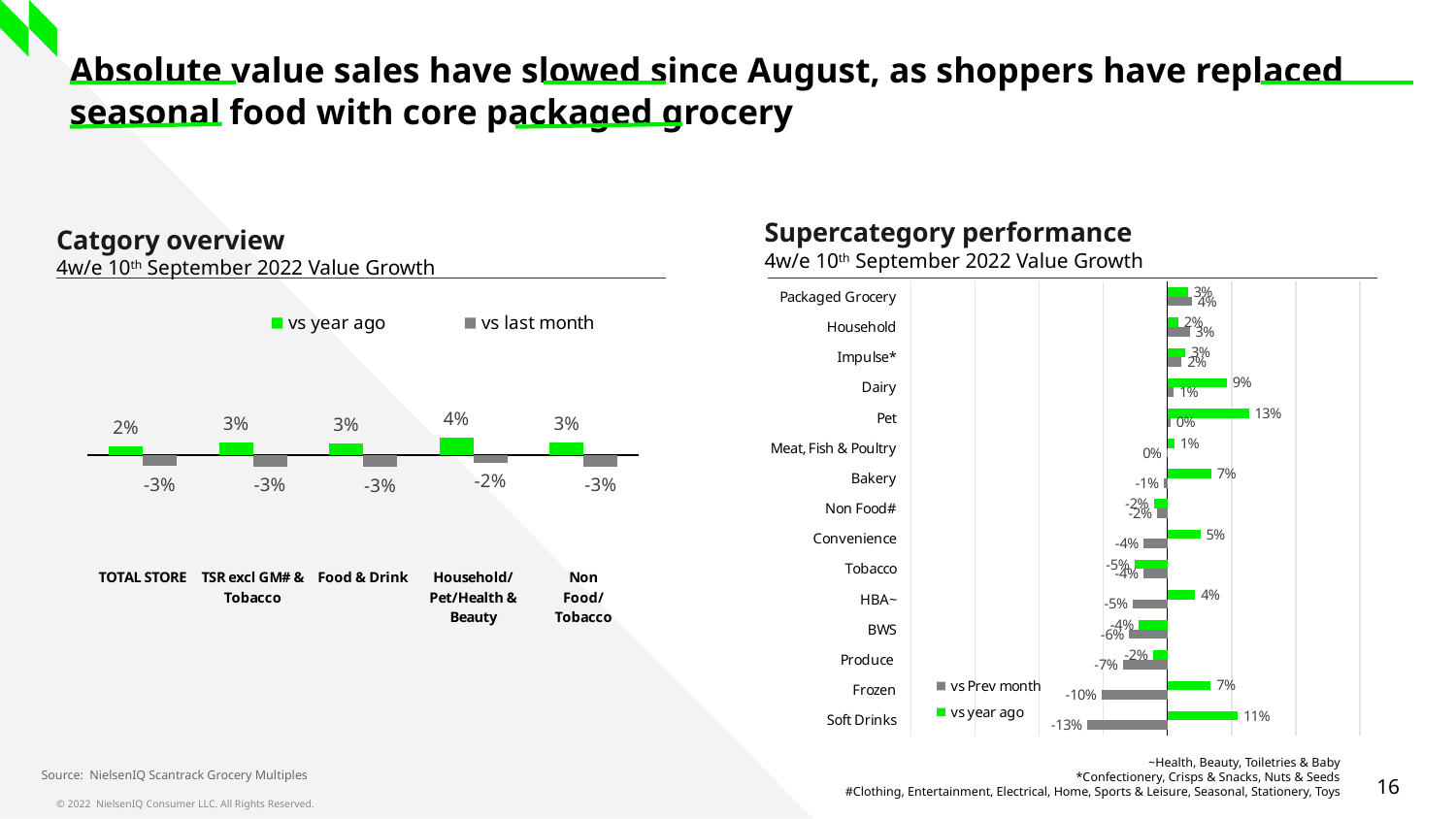
In the 'Supercategory performance' chart, which supercategory has the highest 'vs year ago' value? Pet In the 'Catgory overview' chart, which category has the highest 'vs year ago' value? Household/Pet/Health & Beauty In the 'Supercategory performance' chart, which has the larger 'vs year ago' value, Dairy or Bakery? Dairy In the 'Catgory overview' chart, what is the 'vs year ago' value for Household/Pet/Health & Beauty? 4% In the 'Supercategory performance' chart, what is the 'vs Prev month' value for Soft Drinks? -13% In the 'Supercategory performance' chart, what is the 'vs year ago' value for Pet? 13% In the 'Catgory overview' chart, what is the 'vs last month' value for TOTAL STORE? -3% What kind of chart is the 'Catgory overview' chart on the left? Bar chart In the 'Supercategory performance' chart, which supercategory has the lowest 'vs Prev month' value? Soft Drinks How many series does the legend of the 'Catgory overview' chart list? 2 How many categories are shown in the 'Catgory overview' chart? 5 How many supercategories are listed in the 'Supercategory performance' chart? 15